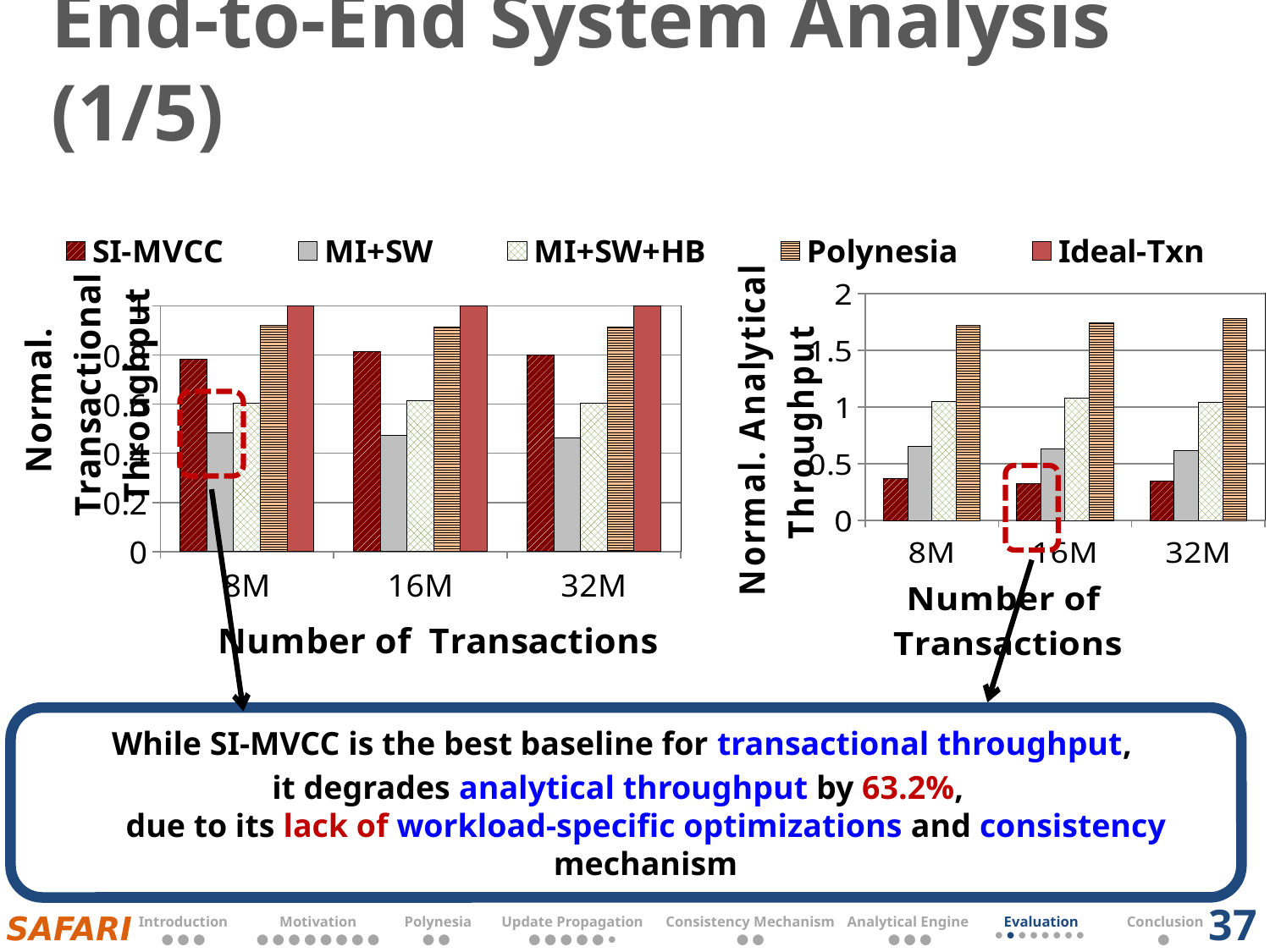
In the Normal. Analytical Throughput chart on the right, which is larger at 32M: Polynesia or MI+SW? Polynesia In the Normal. Analytical Throughput chart on the right, is the value for SI-MVCC at 16M greater or less than 0.5? less What kind of chart is the Normal. Analytical Throughput chart on the right? bar chart In the Normal. Transactional Throughput chart on the left, which is larger at 8M: SI-MVCC or MI+SW? SI-MVCC In the Normal. Transactional Throughput chart on the left, which series has the highest value at 32M? Ideal-Txn How many categories are shown on the x axis of the Normal. Transactional Throughput chart on the left? 3 In the Normal. Transactional Throughput chart on the left, which series has the lowest value at 16M? MI+SW How many series does the legend list for the charts on the slide? 5 In the Normal. Analytical Throughput chart on the right, which series has the lowest value at 8M? SI-MVCC In the Normal. Analytical Throughput chart on the right, which series has the highest value at 8M? Polynesia What is the x-axis title of the Normal. Transactional Throughput chart on the left? Number of Transactions